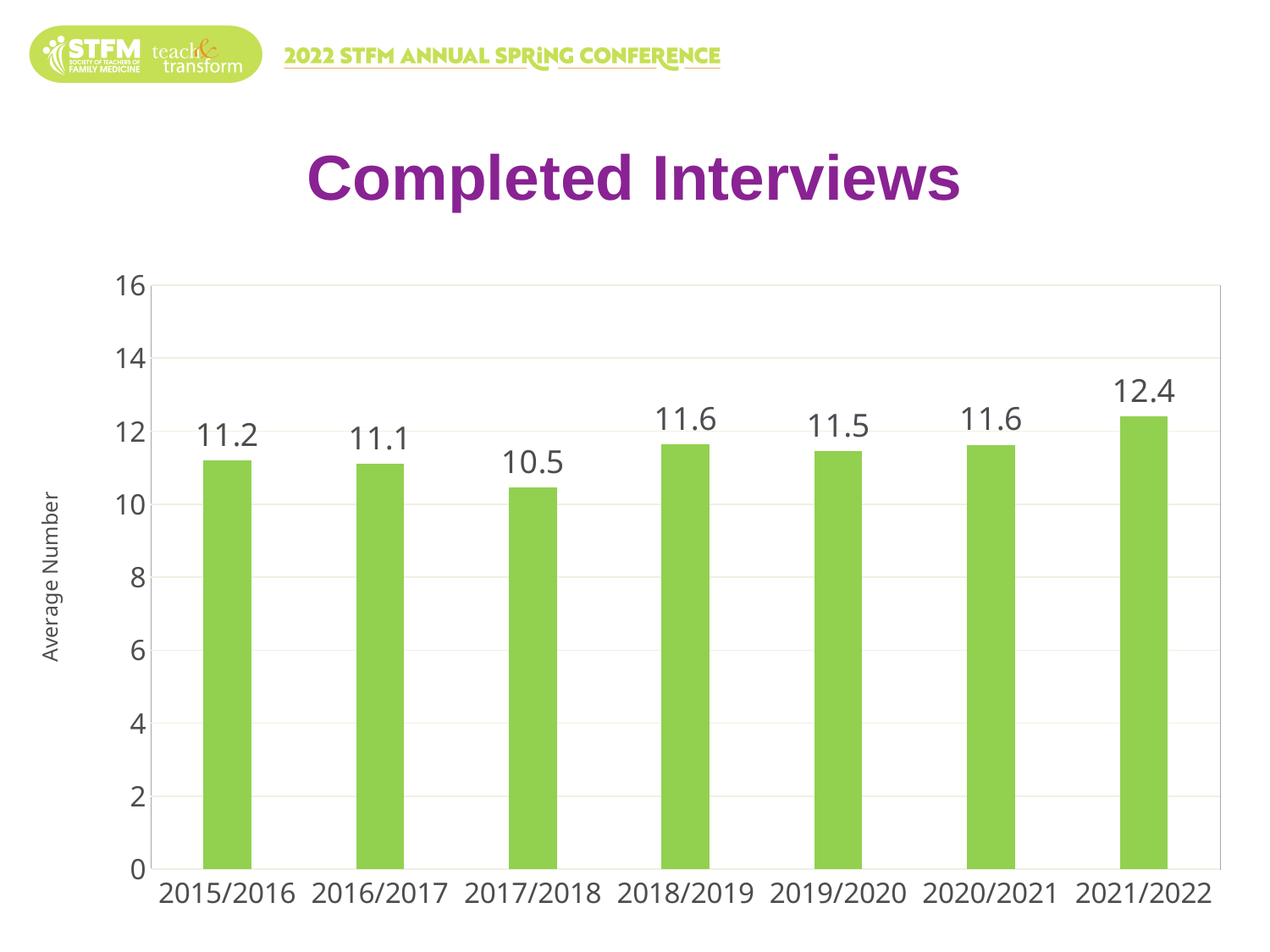
Which year has the lowest average number of completed interviews? 2017/2018 Which year has the highest average number of completed interviews? 2021/2022 What is the average number of completed interviews for 2017/2018? 10.5 How many academic years are shown on the chart? 7 What is the difference between the values for 2021/2022 and 2017/2018? 1.9 What kind of chart is shown on the slide? bar chart What is the label of the vertical axis? Average Number What is the average number of completed interviews for 2015/2016? 11.2 What is the average number of completed interviews for 2021/2022? 12.4 What is the difference between the values for 2018/2019 and 2019/2020? 0.1 Is the value for 2021/2022 greater or less than 12? greater Which is larger, the value for 2015/2016 or the value for 2017/2018? 2015/2016